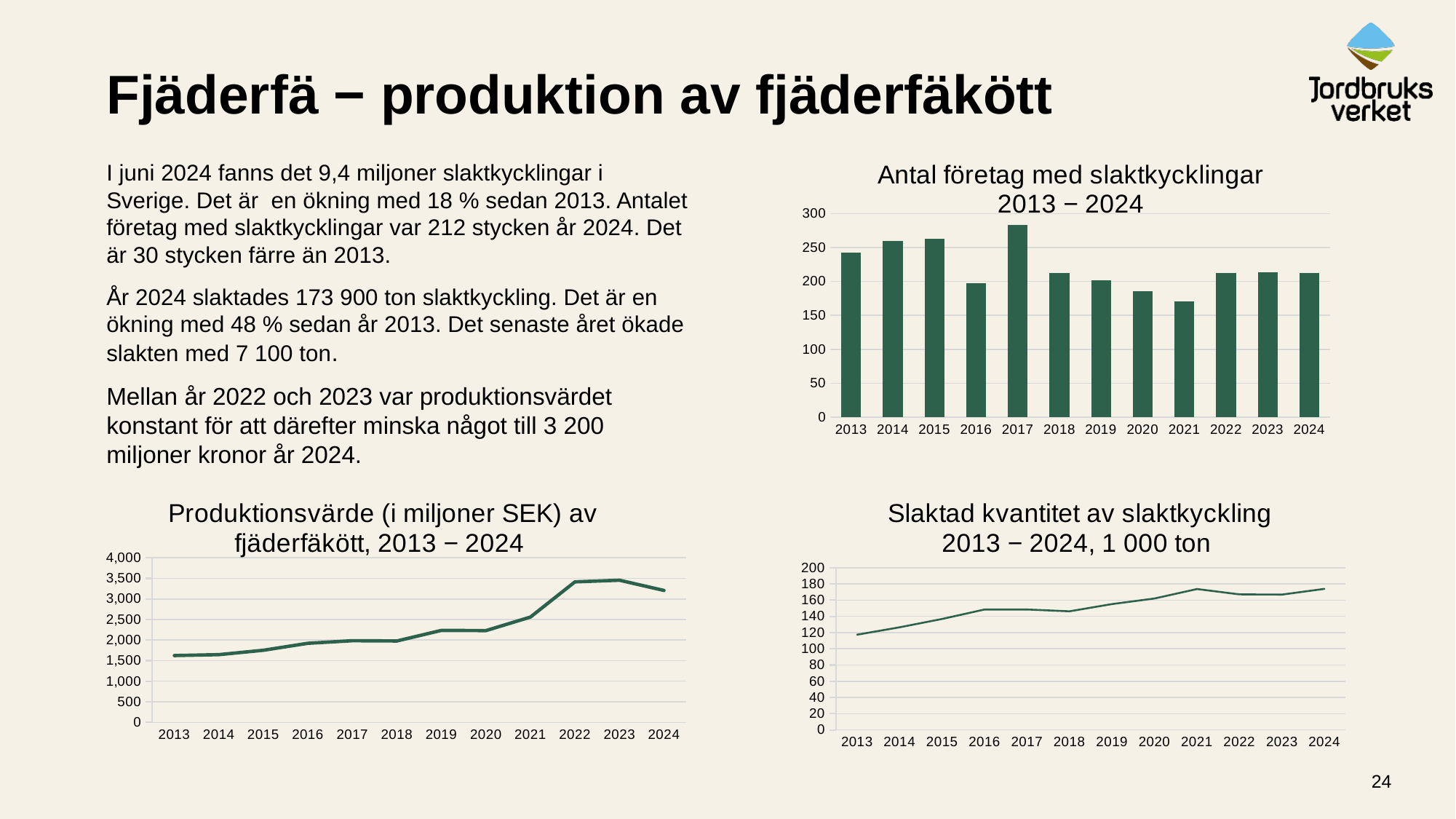
In the chart "Produktionsvärde (i miljoner SEK) av fjäderfäkött, 2013 − 2024", do the values generally rise or fall from 2013 to 2024? rise In the chart "Antal företag med slaktkycklingar 2013 − 2024", how many years are shown on the x axis? 12 What kind of chart is "Antal företag med slaktkycklingar 2013 − 2024"? bar chart In the chart "Antal företag med slaktkycklingar 2013 − 2024", is the value for 2021 greater or less than 200? less In the chart "Antal företag med slaktkycklingar 2013 − 2024", is the value for 2017 greater or less than 250? greater In the chart "Antal företag med slaktkycklingar 2013 − 2024", which year has the highest value? 2017 In the chart "Produktionsvärde (i miljoner SEK) av fjäderfäkött, 2013 − 2024", is the value for 2024 greater or less than 3,000? greater In the chart "Antal företag med slaktkycklingar 2013 − 2024", which is larger, the value for 2013 or the value for 2016? 2013 In the chart "Slaktad kvantitet av slaktkyckling 2013 − 2024, 1 000 ton", which year has the lowest value? 2013 In the chart "Antal företag med slaktkycklingar 2013 − 2024", which year has the lowest value? 2021 What kind of chart is "Produktionsvärde (i miljoner SEK) av fjäderfäkött, 2013 − 2024"? line chart